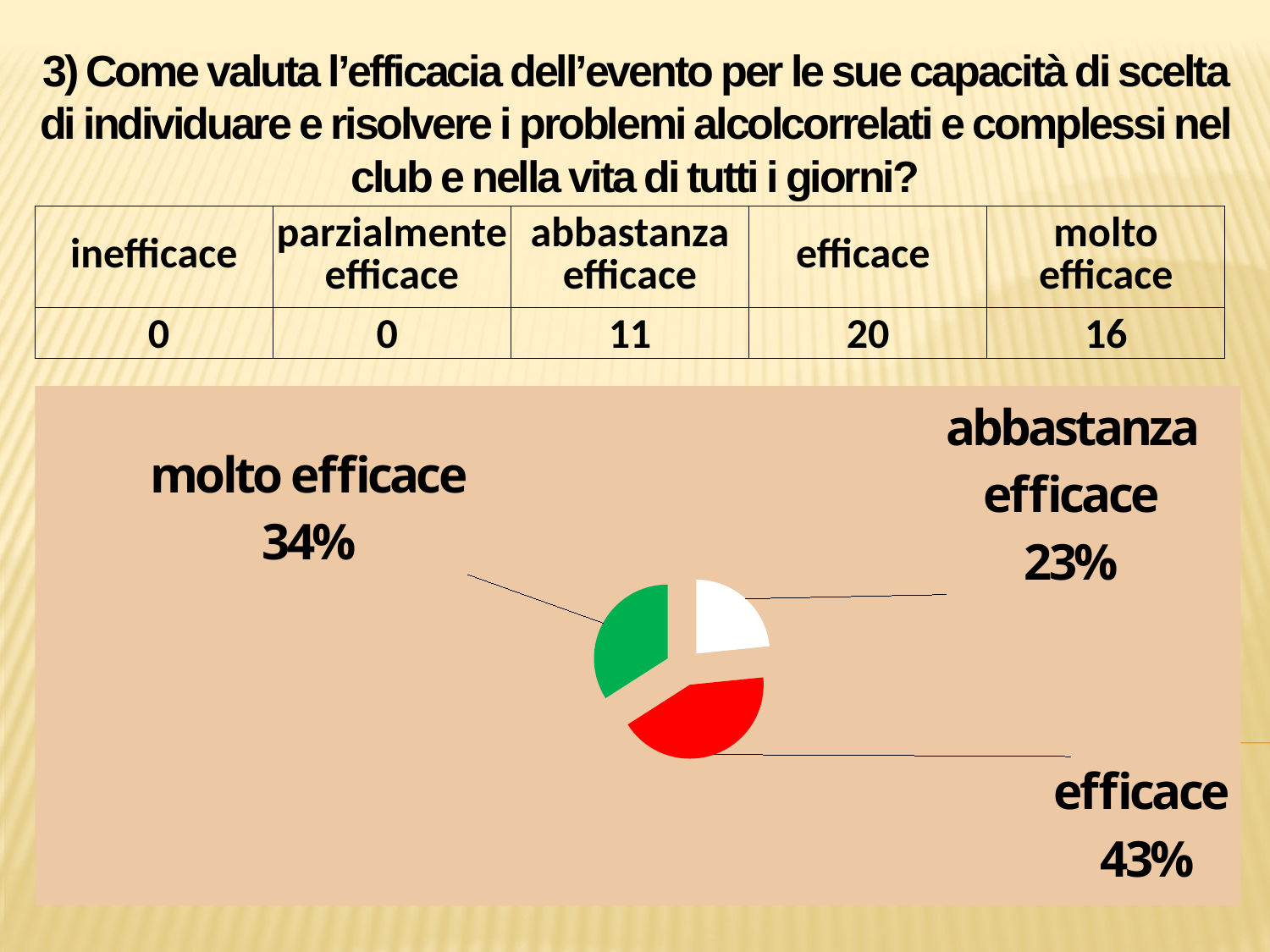
What colour is the "efficace" slice of the pie chart? red What share of the pie does "abbastanza efficace" represent? 23% Which slice of the pie chart is the largest? efficace Which slice of the pie chart is the smallest? abbastanza efficace What share of the pie does "efficace" represent? 43% What share of the pie does "molto efficace" represent? 34% What kind of chart is shown on the slide? pie chart How many slices does the pie chart have? 3 What is the difference in percentage points between the "efficace" and "molto efficace" slices? 9 Which is larger in the pie chart, "molto efficace" or "abbastanza efficace"? molto efficace What colour is the "molto efficace" slice of the pie chart? green What is the difference in percentage points between the "molto efficace" and "abbastanza efficace" slices? 11